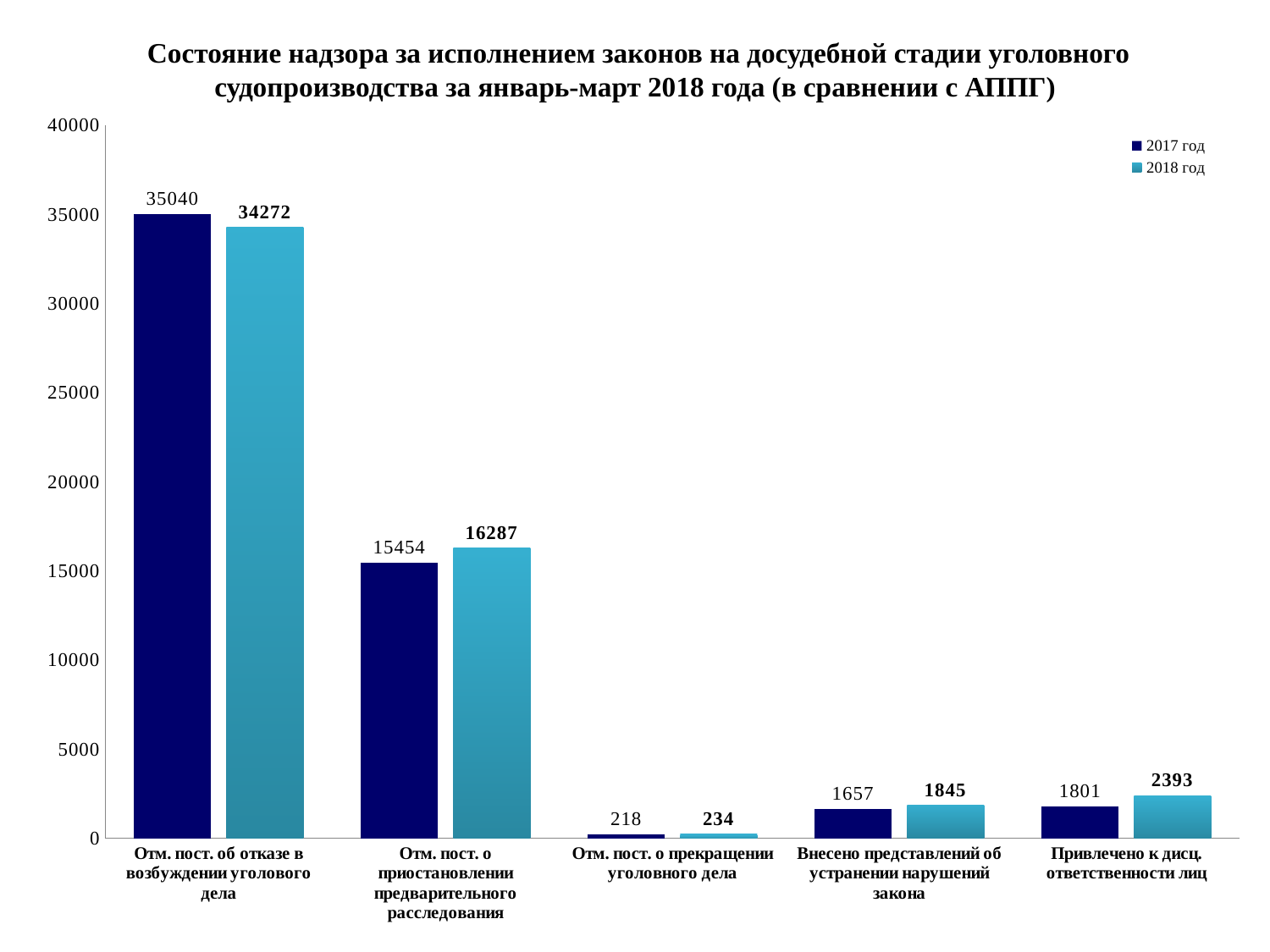
What is the difference between the 2018 год and 2017 год values in the category "Привлечено к дисц. ответственности лиц"? 592 What type of chart is shown on the slide? bar chart Which category has the highest value for 2018 год? Отм. пост. об отказе в возбуждении уголового дела In the category "Отм. пост. об отказе в возбуждении уголового дела", which is larger: the 2017 год value or the 2018 год value? 2017 год How many categories are shown on the x axis? 5 What is the value for 2017 год in the category "Отм. пост. об отказе в возбуждении уголового дела"? 35040 What is the value for 2018 год in the category "Отм. пост. о приостановлении предварительного расследования"? 16287 Which category has the lowest value for 2017 год? Отм. пост. о прекращении уголовного дела What is the value for 2018 год in the category "Привлечено к дисц. ответственности лиц"? 2393 Which series is shown in dark navy blue in the legend? 2017 год How many series does the legend list? 2 What is the difference between the 2017 год and 2018 год values in the category "Внесено представлений об устранении нарушений закона"? 188